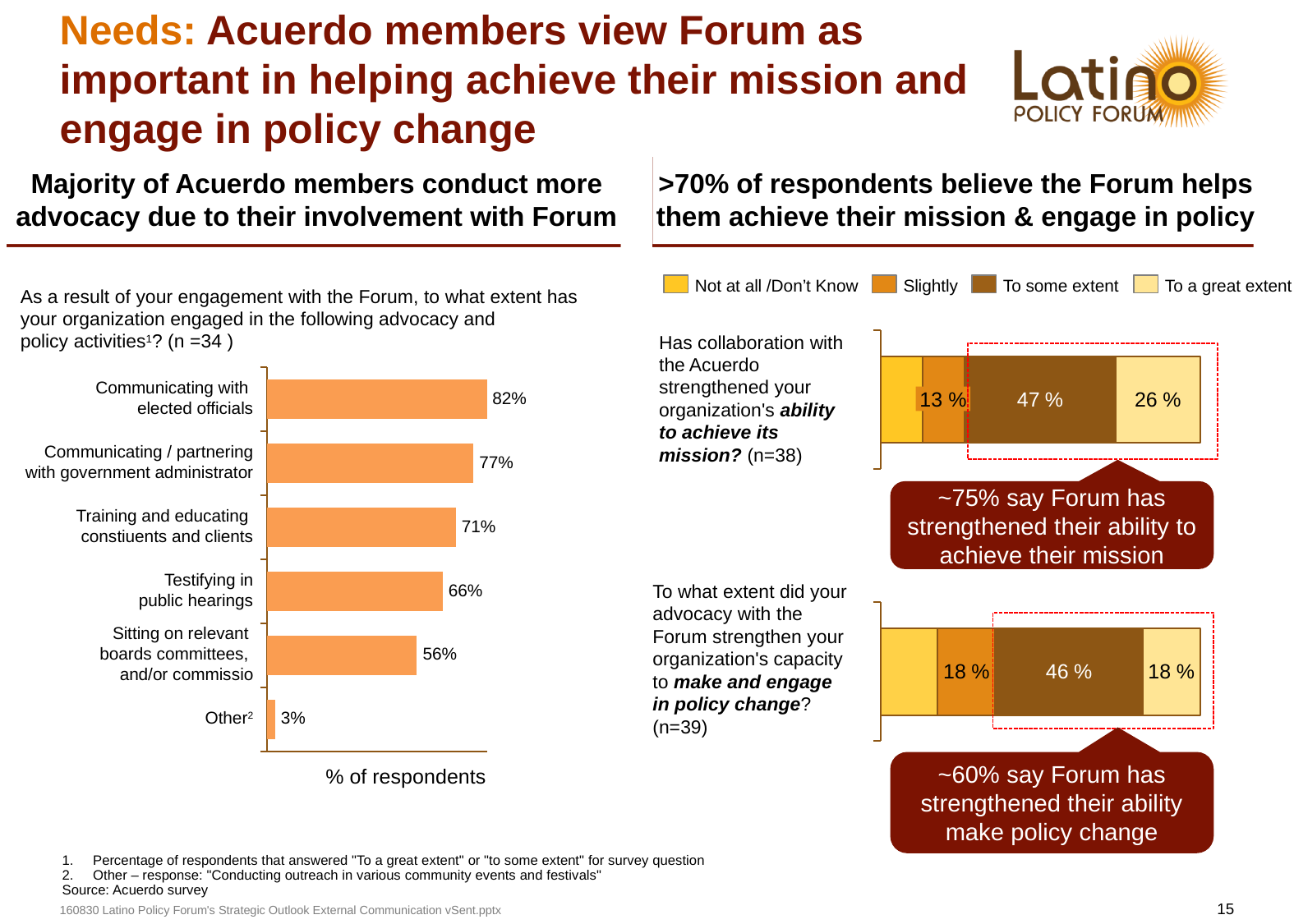
In the stacked bar for 'ability to achieve its mission', what is the combined percentage for 'To some extent' and 'To a great extent'? 73 % In the stacked bar for 'make and engage in policy change', what percentage answered 'To a great extent'? 18 % On the left bar chart, which is larger: 'Training and educating constituents and clients' or 'Testifying in public hearings'? Training and educating constituents and clients How many response categories does the legend on the right side of the slide list? 4 How many activity categories are shown on the left bar chart? 6 On the left bar chart, what is the value for 'Testifying in public hearings'? 66% On the left bar chart, what percentage of respondents reported communicating with elected officials? 82% On the left bar chart, which activity has the highest percentage of respondents? Communicating with elected officials On the left bar chart, what is the difference between 'Communicating with elected officials' and 'Sitting on relevant boards committees, and/or commissions'? 26 percentage points What type of chart is used on the left side of the slide? Bar chart In the stacked bar for 'ability to achieve its mission', what percentage answered 'To some extent'? 47 % On the left bar chart, which activity has the lowest percentage of respondents? Other